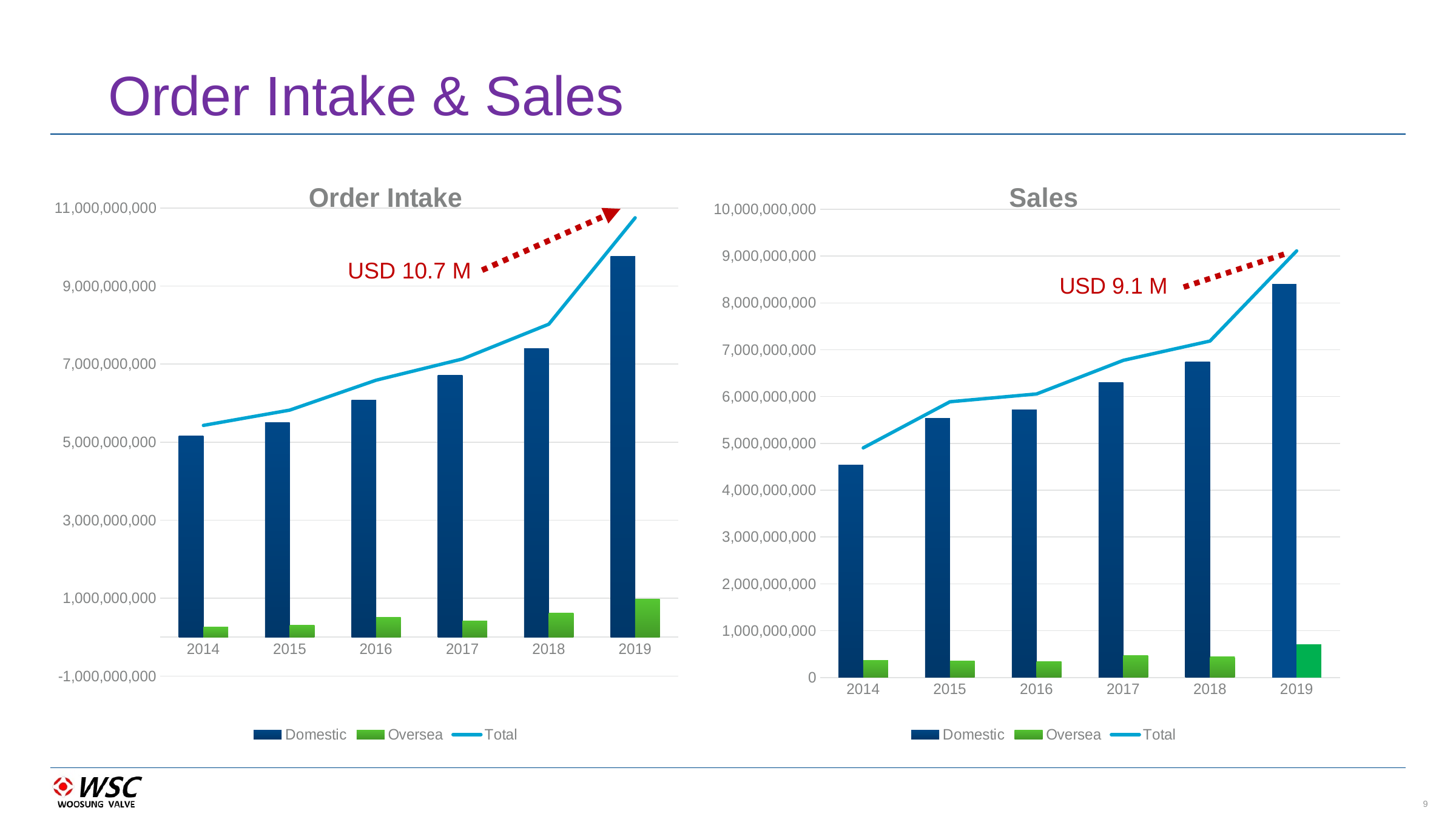
What value does the annotation on the Sales chart give for 2019? USD 9.1 M In the Order Intake chart, which year has the highest Domestic bar? 2019 In the Order Intake chart, is the Domestic value for 2017 greater or less than 7,000,000,000? less How many series does the legend of the Order Intake chart list? 3 In the Order Intake chart, which is larger, the Domestic bar for 2018 or for 2016? 2018 How many years are shown on the x axis of the Sales chart? 6 In the Sales chart, which is larger, the Oversea bar for 2019 or for 2014? 2019 In the Sales chart, is the Domestic value for 2017 greater or less than 6,000,000,000? greater What kind of chart is the Order Intake chart? Combined bar and line chart In the Order Intake chart, does the Total line rise or fall from 2014 to 2019? Rises In the Sales chart, which year has the lowest Domestic bar? 2014 In the Sales chart, is the Oversea value for 2019 greater or less than 1,000,000,000? less